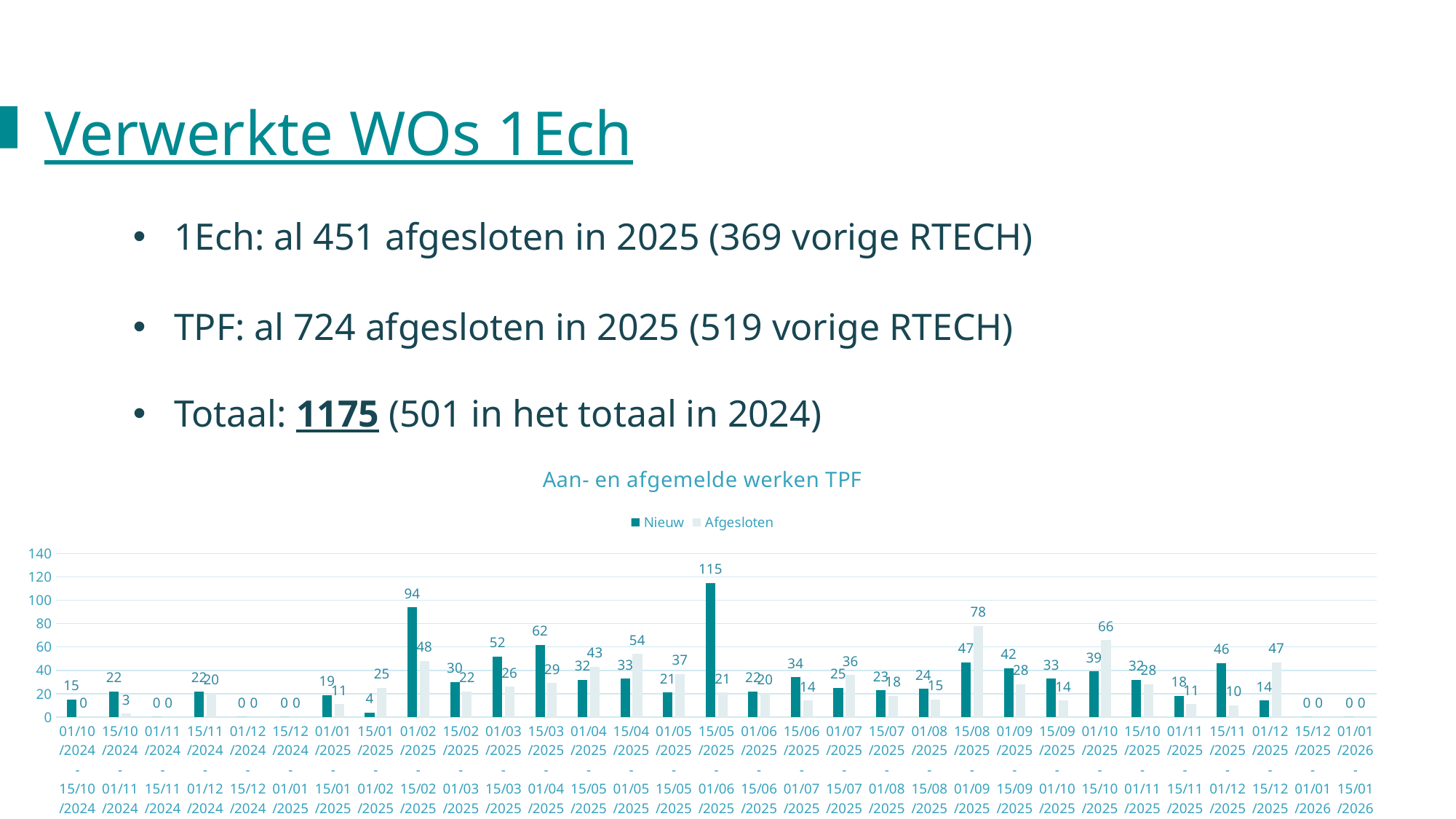
What is the difference between the Nieuw and Afgesloten values for the period 15/05/2025 - 01/06/2025? 94 How many series does the chart legend list? 2 What is the Afgesloten value for the period 15/04/2025 - 01/05/2025? 54 Which period has the highest Afgesloten value? 15/08/2025 - 01/09/2025 Which period has the highest Nieuw value? 15/05/2025 - 01/06/2025 What type of chart is shown on the slide? bar chart What is the title of the chart? Aan- en afgemelde werken TPF What is the Nieuw value for the period 15/11/2025 - 01/12/2025? 46 What is the difference between the Nieuw values for 01/02/2025 - 15/02/2025 and 15/03/2025 - 01/04/2025? 32 What is the Nieuw value for the period 01/02/2025 - 15/02/2025? 94 For the period 01/10/2025 - 15/10/2025, which is larger: Nieuw or Afgesloten? Afgesloten What is the Afgesloten value for the period 15/08/2025 - 01/09/2025? 78